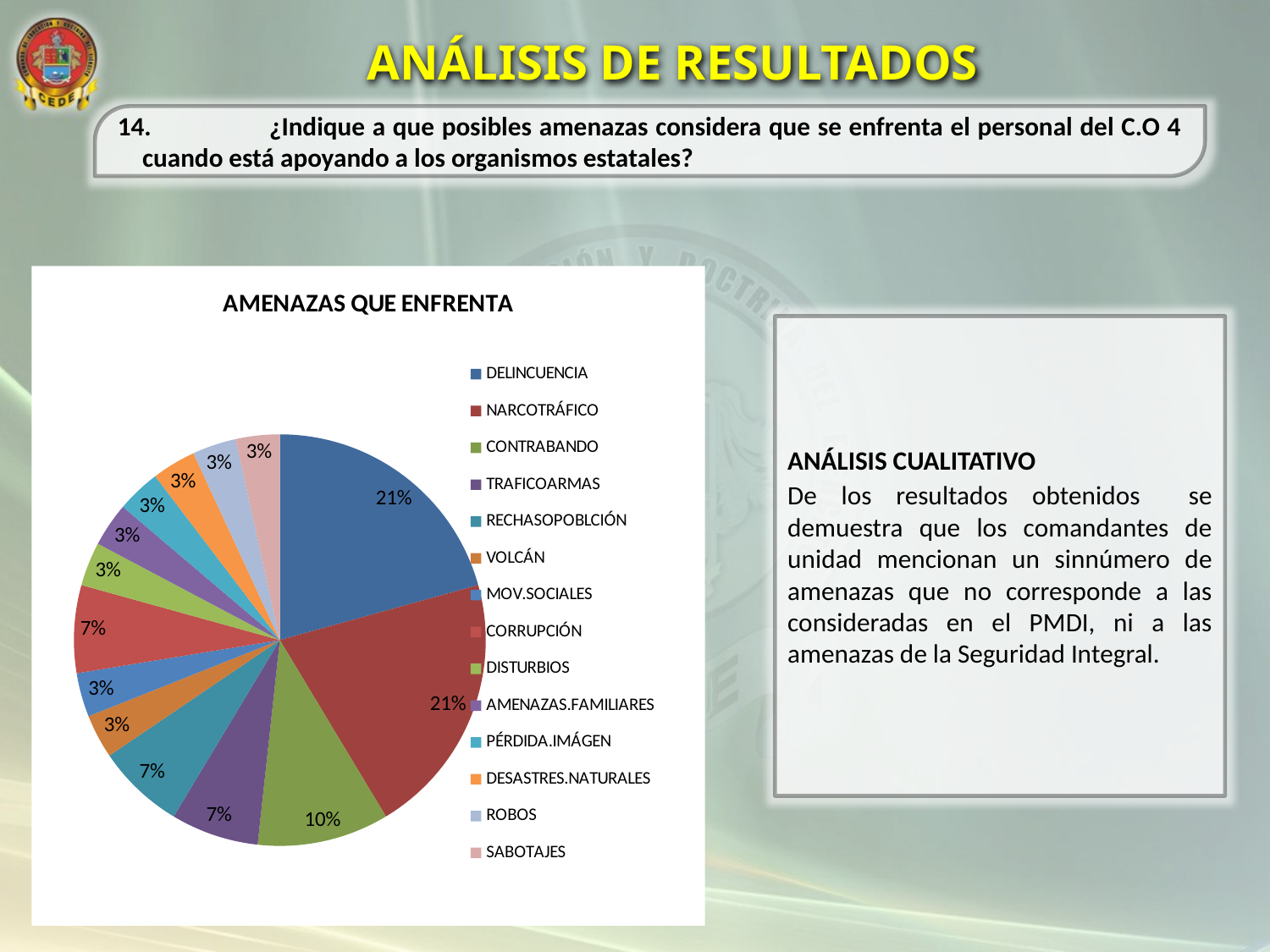
Which is larger, the share for NARCOTRÁFICO or the share for ROBOS? NARCOTRÁFICO What is the title of the chart? AMENAZAS QUE ENFRENTA What kind of chart is shown on the slide? pie chart How many categories does the legend of the pie chart list? 14 What share of the pie does CORRUPCIÓN represent? 7% What share of the pie does SABOTAJES represent? 3% Which is larger, the share for CONTRABANDO or the share for TRAFICOARMAS? CONTRABANDO What share of the pie does TRAFICOARMAS represent? 7% What is the difference in percentage points between the share for DELINCUENCIA and the share for CONTRABANDO? 11